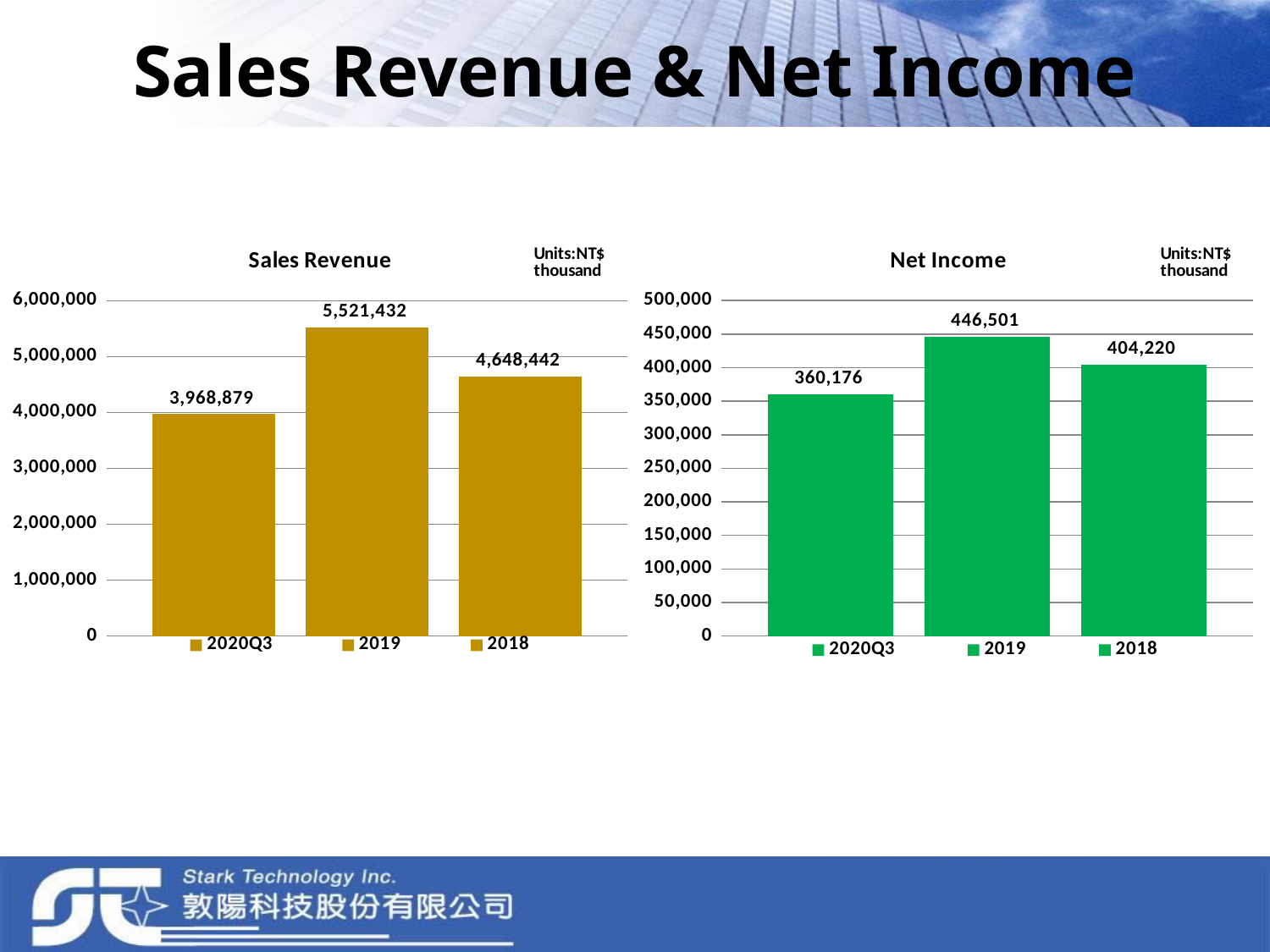
In the Net Income chart, what is the difference between the 2019 and 2018 values? 42,281 In the Sales Revenue chart, what is the value for 2019? 5,521,432 In the Sales Revenue chart, what is the value for 2018? 4,648,442 In the Sales Revenue chart, what is the difference between the 2019 and 2020Q3 values? 1,552,553 What units are stated for the Net Income chart? NT$ thousand How many bars are shown in the Net Income chart? 3 In the Sales Revenue chart, which period has the lowest value? 2020Q3 In the Sales Revenue chart, is the value for 2018 greater or less than 4,000,000? greater In the Net Income chart, what is the value for 2020Q3? 360,176 What type of chart is the Sales Revenue chart? Bar chart In the Net Income chart, which is larger, the value for 2018 or the value for 2020Q3? 2018 In the Net Income chart, which period has the highest value? 2019